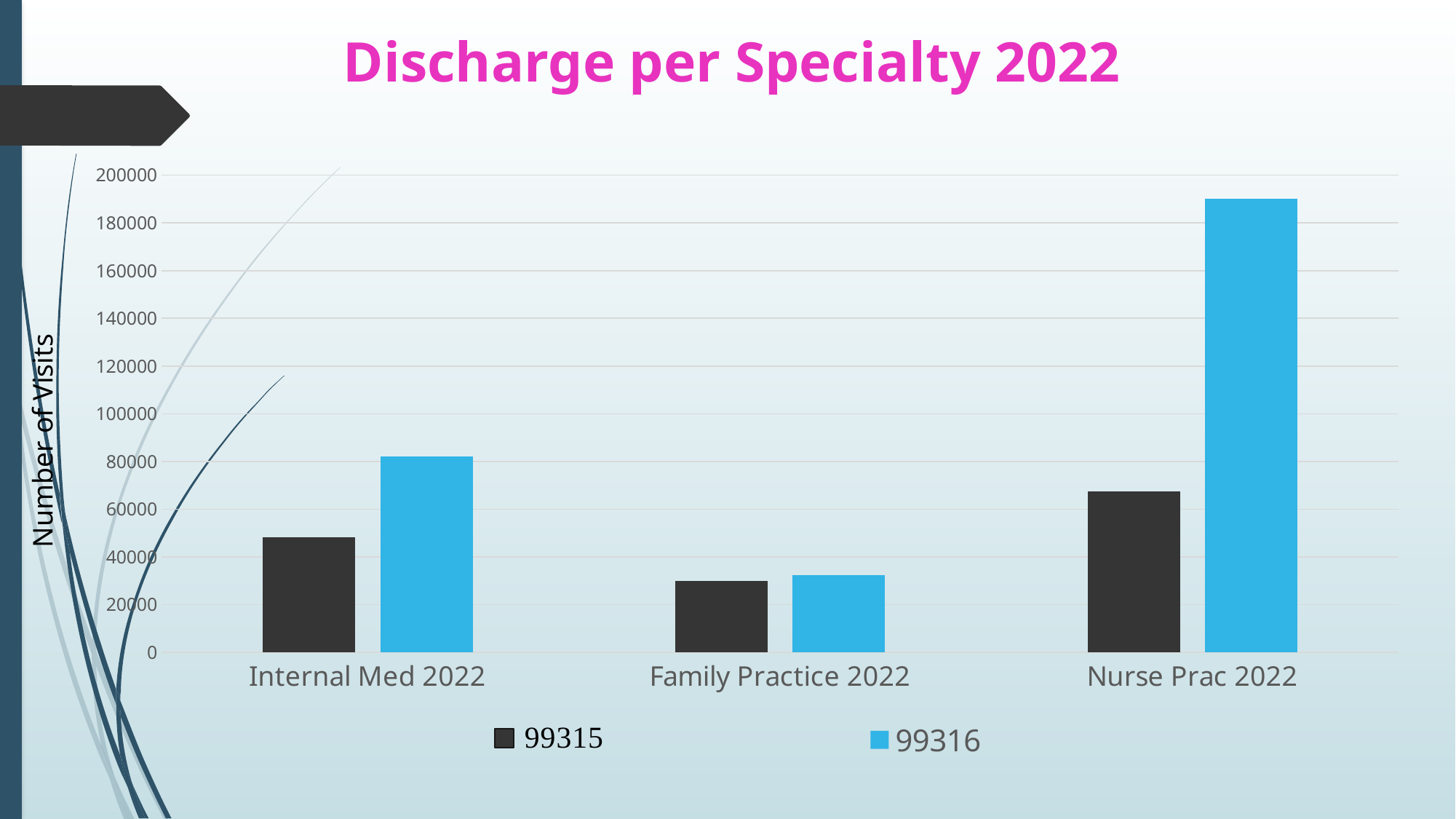
Which category has the highest value for the 99315 series? Nurse Prac 2022 Which category has the lowest value for the 99316 series? Family Practice 2022 For Nurse Prac 2022, which series has the larger value, 99315 or 99316? 99316 How many specialty categories are shown on the x axis? 3 What kind of chart is shown on the slide? bar chart Is the 99315 value for Internal Med 2022 greater or less than 60000? less Which category has the highest value for the 99316 series? Nurse Prac 2022 How many series does the legend list? 2 What is the label on the vertical axis? Number of Visits Is the 99316 value for Nurse Prac 2022 greater or less than 180000? greater Which category has the lowest value for the 99315 series? Family Practice 2022 For Internal Med 2022, which series has the larger value, 99315 or 99316? 99316